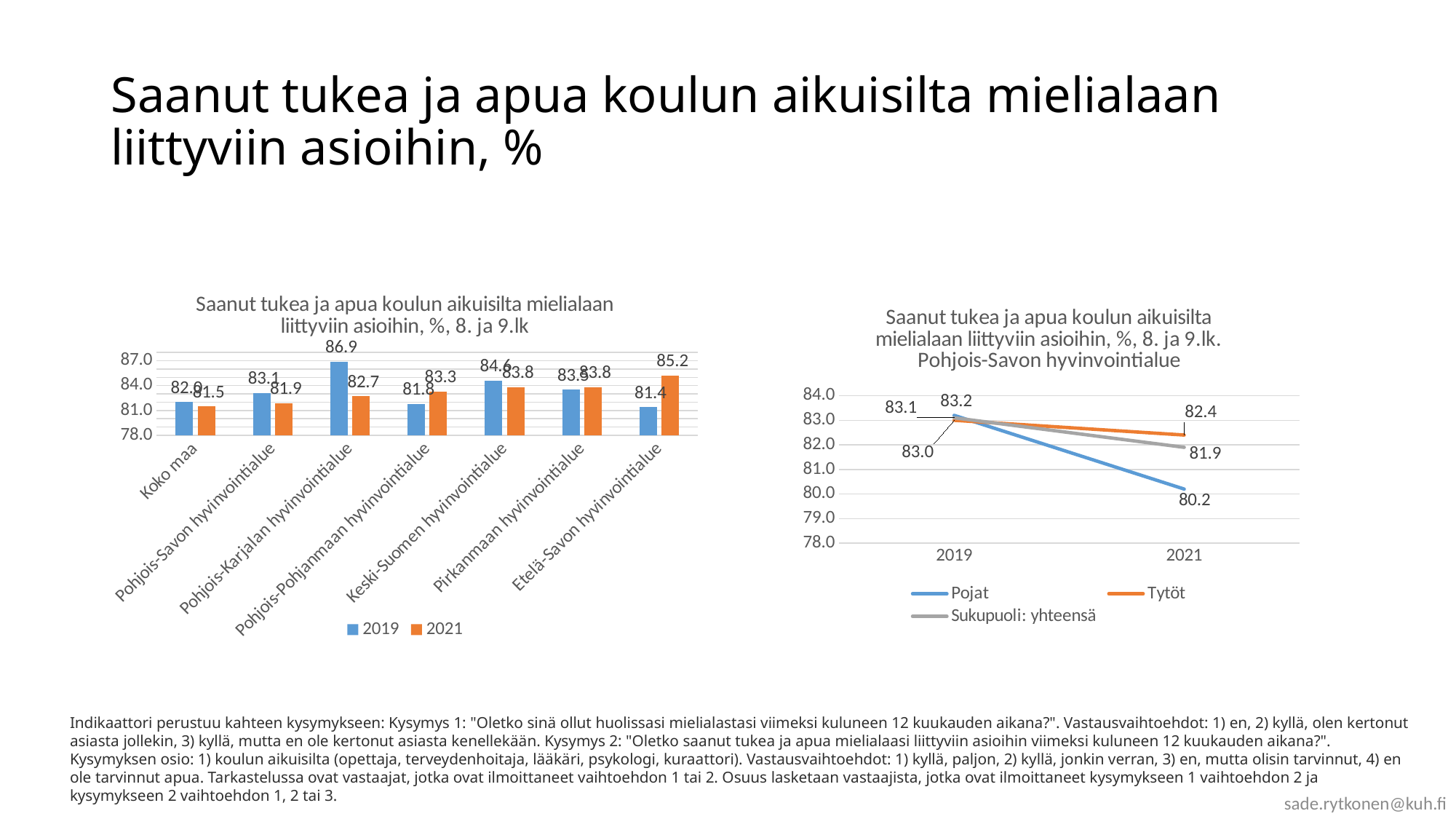
In the right line chart, what is the 2021 value for Pojat? 80.2 In the left bar chart, which category has the highest 2019 value? Pohjois-Karjalan hyvinvointialue In the left bar chart, what is the 2019 value for Pohjois-Karjalan hyvinvointialue? 86.9 In the left bar chart, what is the 2021 value for Koko maa? 81.5 How many series does the legend of the left bar chart list? 2 In the left bar chart, what is the 2021 value for Etelä-Savon hyvinvointialue? 85.2 In the left bar chart, which category has the lowest 2019 value? Etelä-Savon hyvinvointialue What kind of chart is the right-hand chart for Pohjois-Savon hyvinvointialue? Line chart In the right line chart, does the Pojat line rise or fall from 2019 to 2021? Fall In the left bar chart, what is the difference between the 2019 and 2021 values for Pohjois-Karjalan hyvinvointialue? 4.2 In the left bar chart, is the 2019 value for Keski-Suomen hyvinvointialue larger or the 2021 value? 2019 How many categories are shown on the x axis of the left bar chart? 7